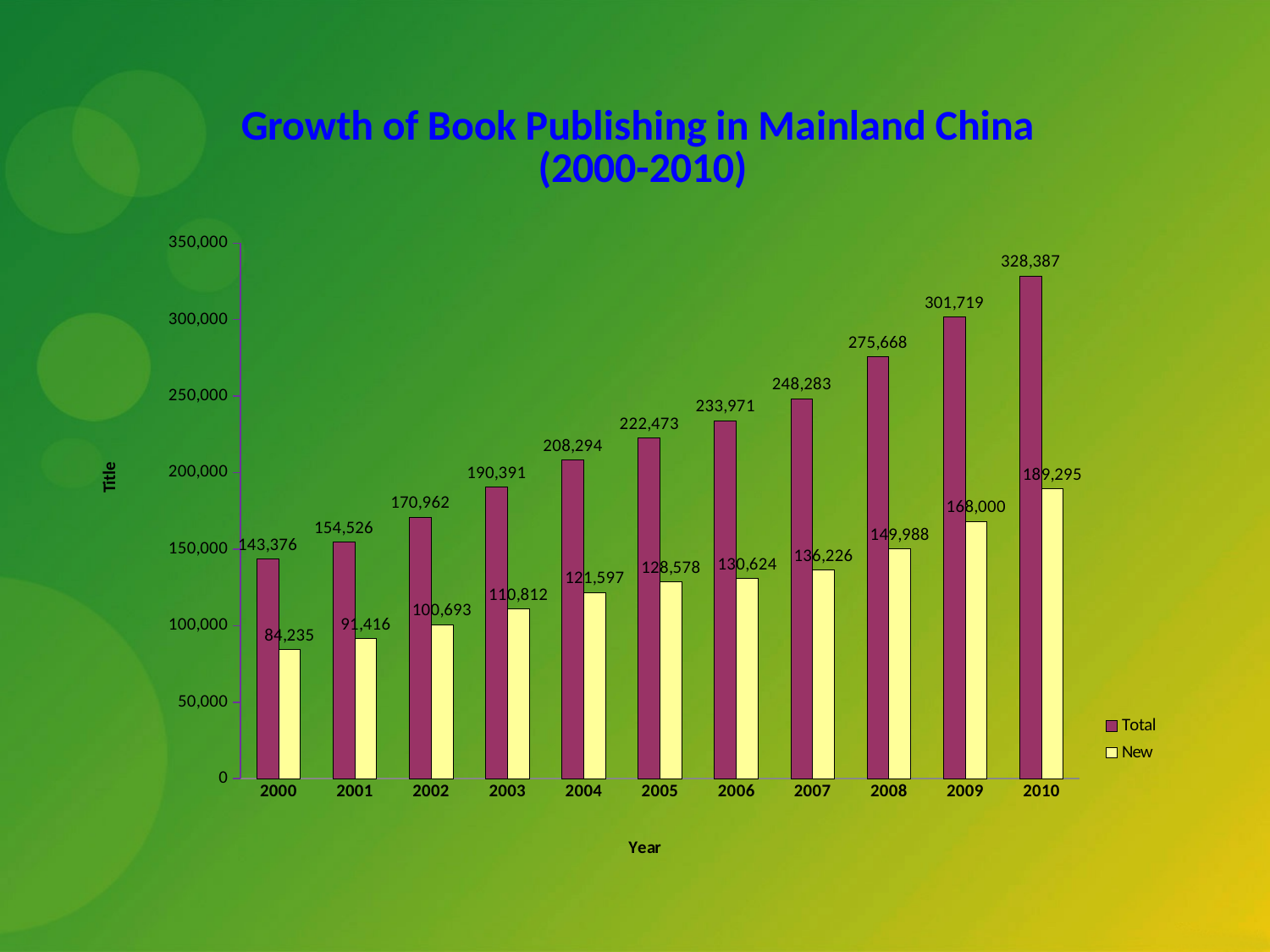
What is the Total value for 2005? 222,473 How many series does the legend list? 2 What is the difference between the Total and New values for 2010? 139,092 What is the New value for 2008? 149,988 What kind of chart is shown on the slide? Bar chart What is the Total value for 2000? 143,376 Do the Total values rise or fall from 2000 to 2010? Rise Is the New value for 2009 greater or less than 150,000? greater How many years are shown on the x axis? 11 Which is larger, the Total value for 2003 or the New value for 2010? Total value for 2003 Which year has the highest Total value? 2010 Which year has the lowest New value? 2000